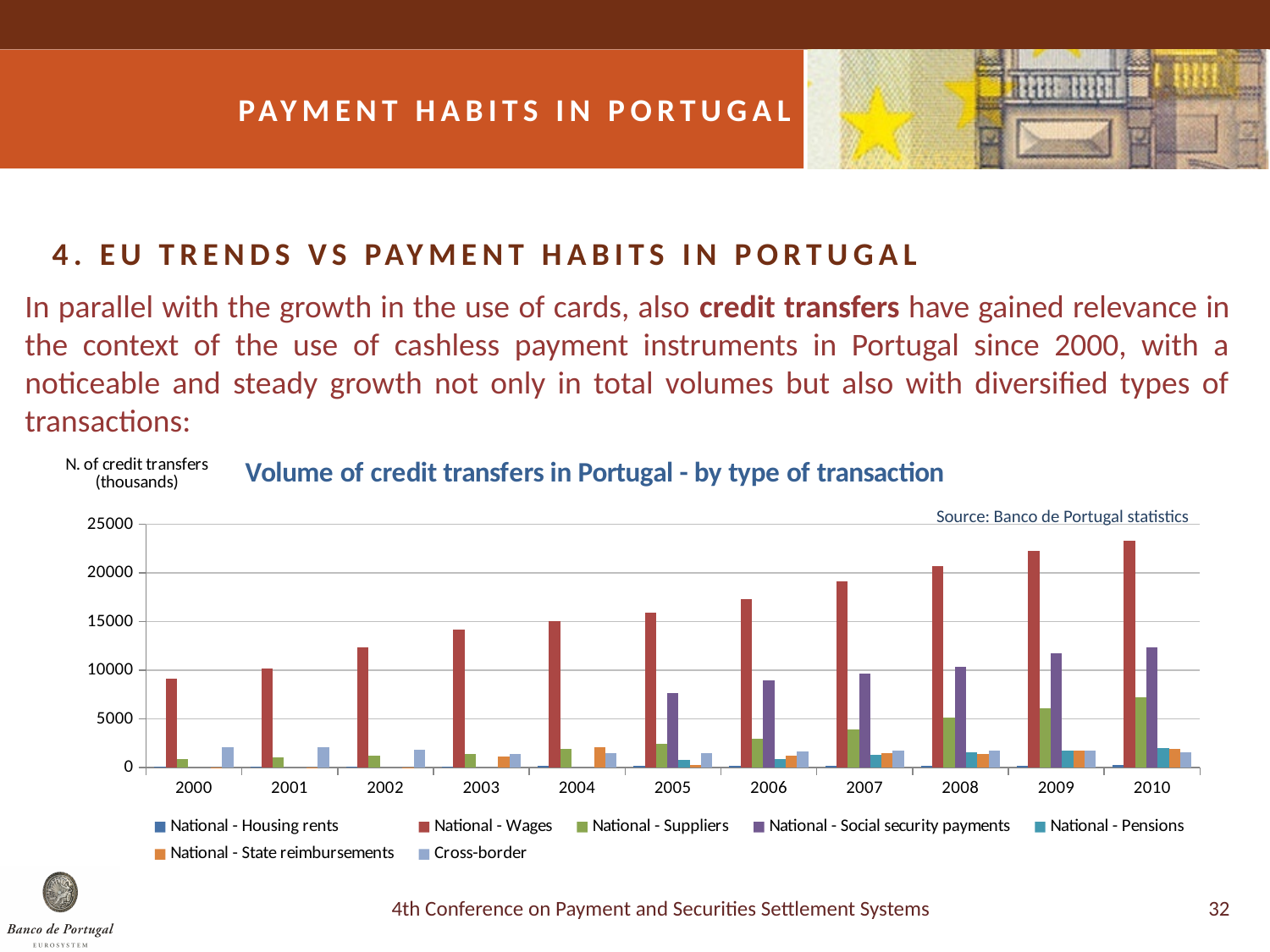
What type of chart is shown on the slide? bar chart Do the values for National - Wages rise or fall from 2000 to 2010? rise How many series does the legend list? 7 Is the value for National - Wages in 2000 greater or less than 10000? less Is the value for National - Wages in 2010 greater or less than 20000? greater In which year is the value for National - Wages highest? 2010 In 2010, which is larger: National - Social security payments or National - Suppliers? National - Social security payments What is the source cited for the chart? Banco de Portugal statistics Is the value for National - Suppliers in 2010 greater or less than 5000? greater How many years are shown on the x axis? 11 Which type of transaction has the highest volume in 2010? National - Wages